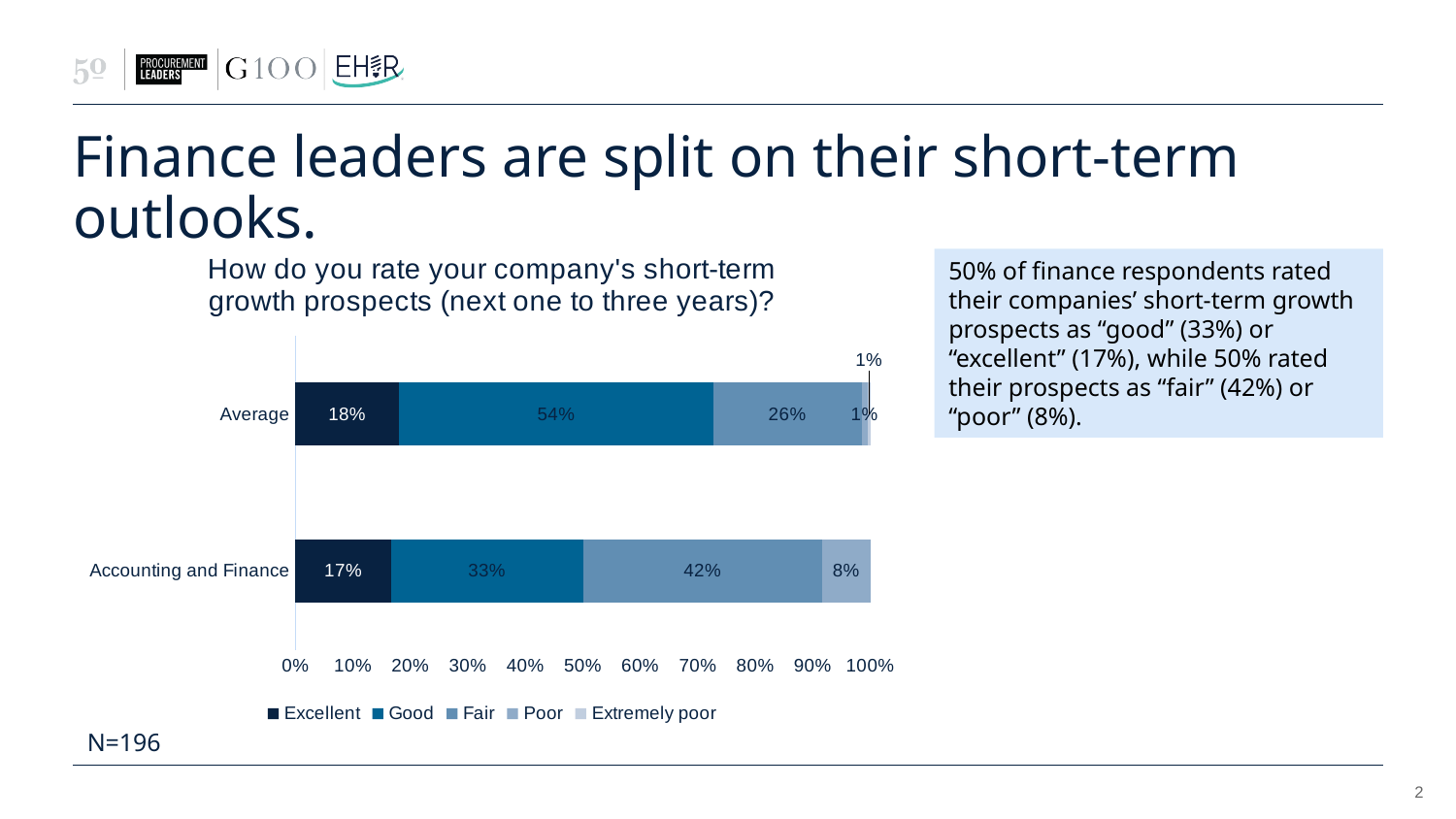
What is the title of the chart? How do you rate your company's short-term growth prospects (next one to three years)? Which is larger: the "Fair" value for Accounting and Finance or the "Fair" value for Average? Accounting and Finance Which rating has the largest share for Accounting and Finance? Fair What is the "Poor" value for Accounting and Finance? 8% How many categories are plotted on the chart? 2 How many series does the legend list? 5 Which rating has the largest share for Average? Good What is the "Good" value for Accounting and Finance? 33% What is the difference between the "Good" values for Average and Accounting and Finance? 21% What kind of chart is shown on the slide? Stacked bar chart What is the "Excellent" value for Average? 18% What is the "Fair" value for Average? 26%